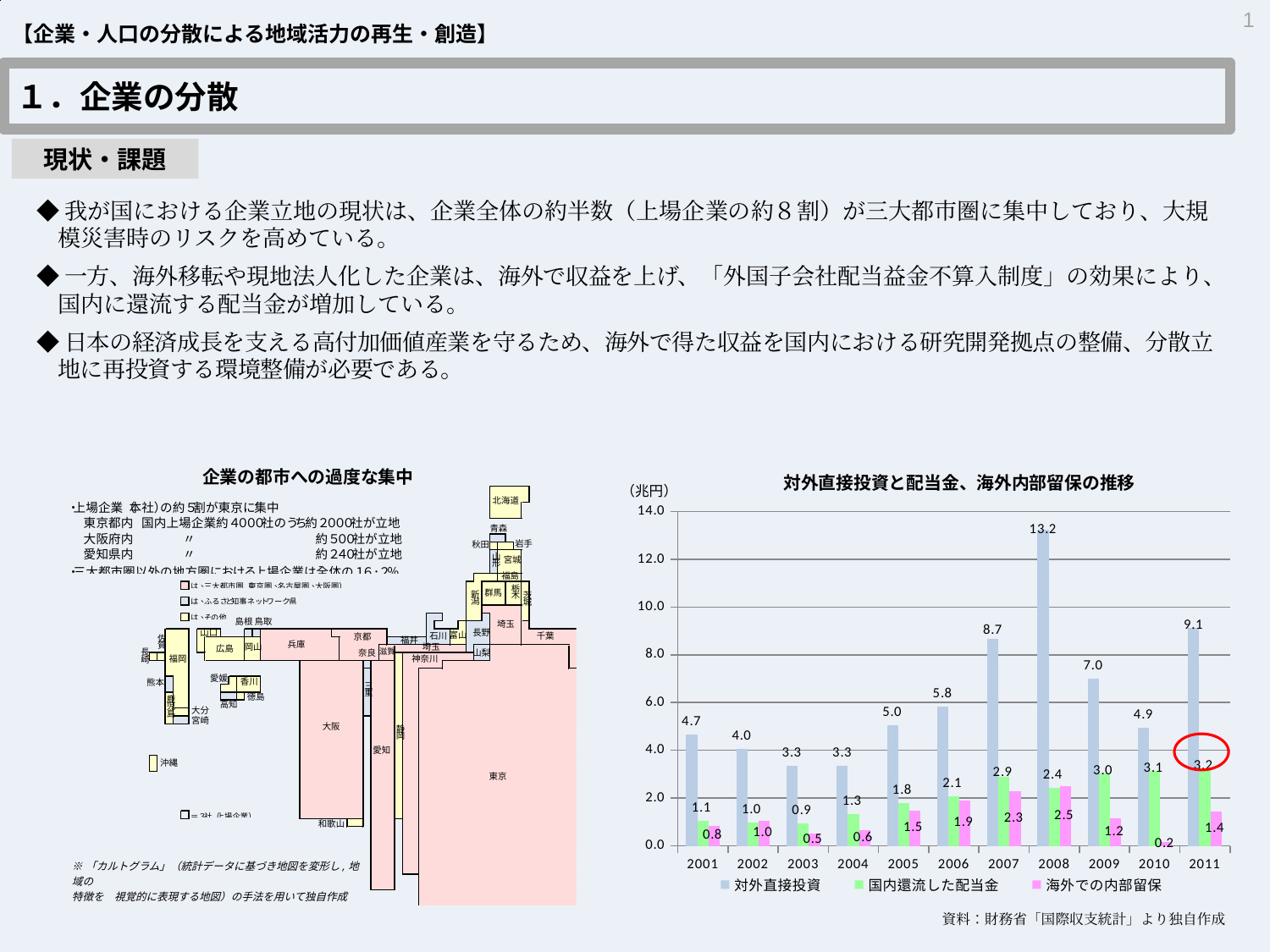
In the chart titled 対外直接投資と配当金、海外内部留保の推移, what is the difference between 対外直接投資 in 2008 and in 2009? 6.2 In the chart titled 対外直接投資と配当金、海外内部留保の推移, what is the value of 対外直接投資 in 2008? 13.2 What kind of chart is 対外直接投資と配当金、海外内部留保の推移? bar chart In the chart titled 対外直接投資と配当金、海外内部留保の推移, what is the value of 国内還流した配当金 in 2011? 3.2 In the chart titled 対外直接投資と配当金、海外内部留保の推移, what unit is shown at the top of the y axis? 兆円 In the chart titled 対外直接投資と配当金、海外内部留保の推移, how many years are shown on the x axis? 11 In the chart titled 対外直接投資と配当金、海外内部留保の推移, which is larger in 2007: 国内還流した配当金 or 海外での内部留保? 国内還流した配当金 In the chart titled 対外直接投資と配当金、海外内部留保の推移, which year has the highest value for 対外直接投資? 2008 In the chart titled 対外直接投資と配当金、海外内部留保の推移, which year has the lowest value for 海外での内部留保? 2010 In the chart titled 対外直接投資と配当金、海外内部留保の推移, how many series does the legend list? 3 In the chart titled 対外直接投資と配当金、海外内部留保の推移, what is the value of 海外での内部留保 in 2010? 0.2 In the chart titled 対外直接投資と配当金、海外内部留保の推移, does 国内還流した配当金 rise or fall from 2008 to 2011? rise